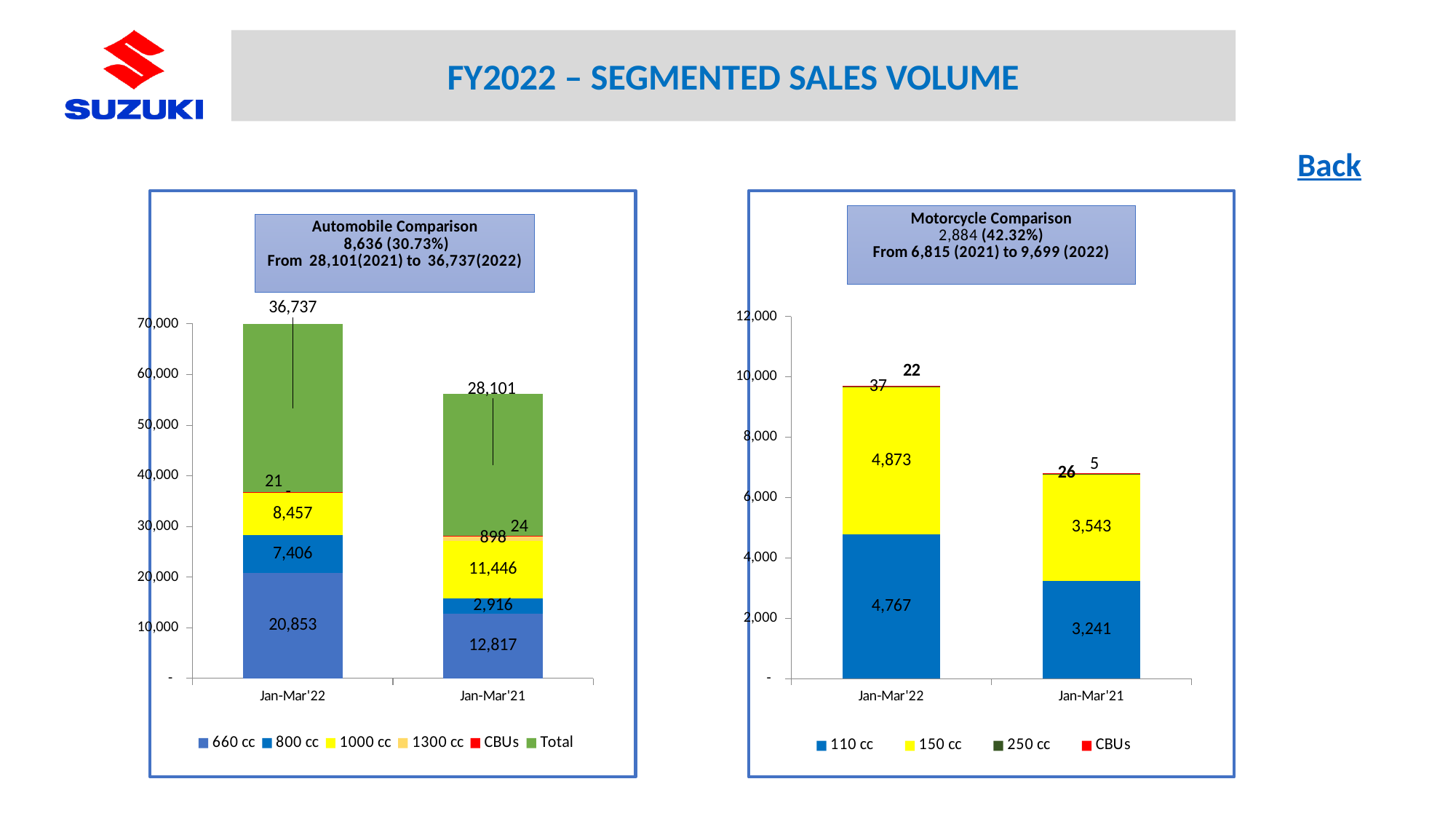
In the Motorcycle Comparison chart, what is the difference between the 150 cc values for Jan-Mar'22 and Jan-Mar'21? 1,330 In the Automobile Comparison chart, what is the total labelled above the Jan-Mar'22 bar? 36,737 In the Motorcycle Comparison chart, what is the 110 cc value for Jan-Mar'22? 4,767 In the Automobile Comparison chart, what is the 1000 cc value for Jan-Mar'21? 11,446 What kind of chart is the Automobile Comparison chart on the left? Stacked bar chart How many series does the legend of the Automobile Comparison chart list? 6 How many series does the legend of the Motorcycle Comparison chart list? 4 How many periods (categories) are shown on the x axis of the Motorcycle Comparison chart? 2 In the Automobile Comparison chart, which period has the larger 1000 cc value, Jan-Mar'22 or Jan-Mar'21? Jan-Mar'21 In the Motorcycle Comparison chart, what is the 150 cc value for Jan-Mar'21? 3,543 In the Automobile Comparison chart, what is the 660 cc value for Jan-Mar'22? 20,853 In the Automobile Comparison chart, what is the difference between the 660 cc values for Jan-Mar'22 and Jan-Mar'21? 8,036